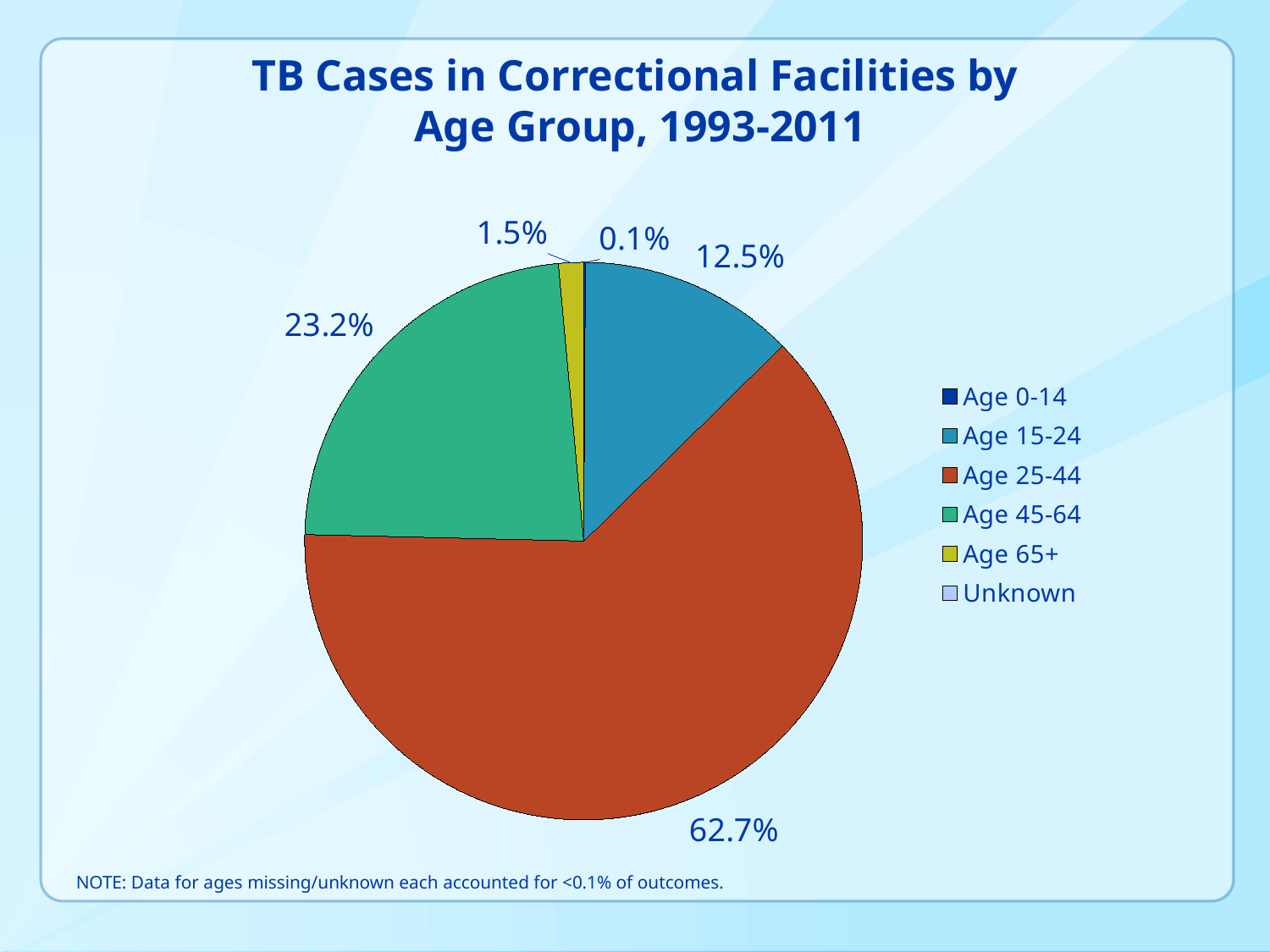
What is the difference between the shares for Age 25-44 and Age 45-64? 39.5% What share of TB cases is in the Age 0-14 group? 0.1% How many entries does the legend list? 6 Which age group accounts for the largest share of TB cases? Age 25-44 What is the title of the chart? TB Cases in Correctional Facilities by Age Group, 1993-2011 Which has the larger share, Age 15-24 or Age 45-64? Age 45-64 What share of TB cases is in the Age 25-44 group? 62.7% What share of TB cases is in the Age 15-24 group? 12.5% What kind of chart is shown on the slide? Pie chart Which of the labelled age groups accounts for the smallest share of TB cases? Age 0-14